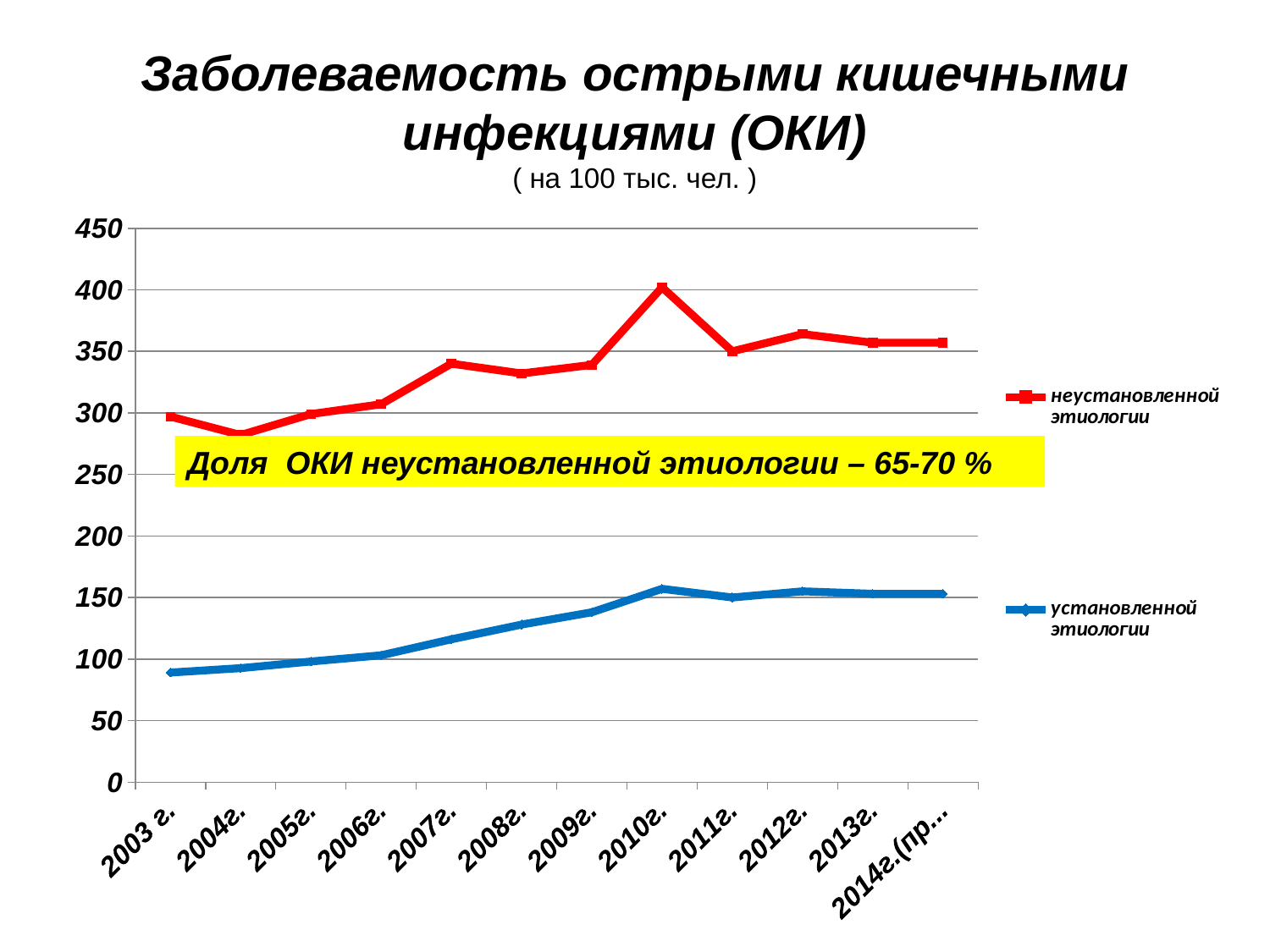
How many series does the legend list? 2 What colour is the line for the series 'неустановленной этиологии'? red How many years (points) are plotted along the x axis? 12 In which year is the series 'установленной этиологии' at its lowest value? 2003 г. What kind of chart is shown on the slide? line chart In which year does the series 'неустановленной этиологии' reach its highest value? 2010г. Does the series 'установленной этиологии' rise or fall from 2003 г. to 2010г.? rise Which series has the larger value in 2010г., 'неустановленной этиологии' or 'установленной этиологии'? неустановленной этиологии Is the value for 'установленной этиологии' in 2003 г. greater or less than 100? less In which year is the series 'неустановленной этиологии' at its lowest value? 2004г. Is the value for 'неустановленной этиологии' in 2007г. greater or less than 350? less Is the value for 'неустановленной этиологии' in 2004г. greater or less than 300? less